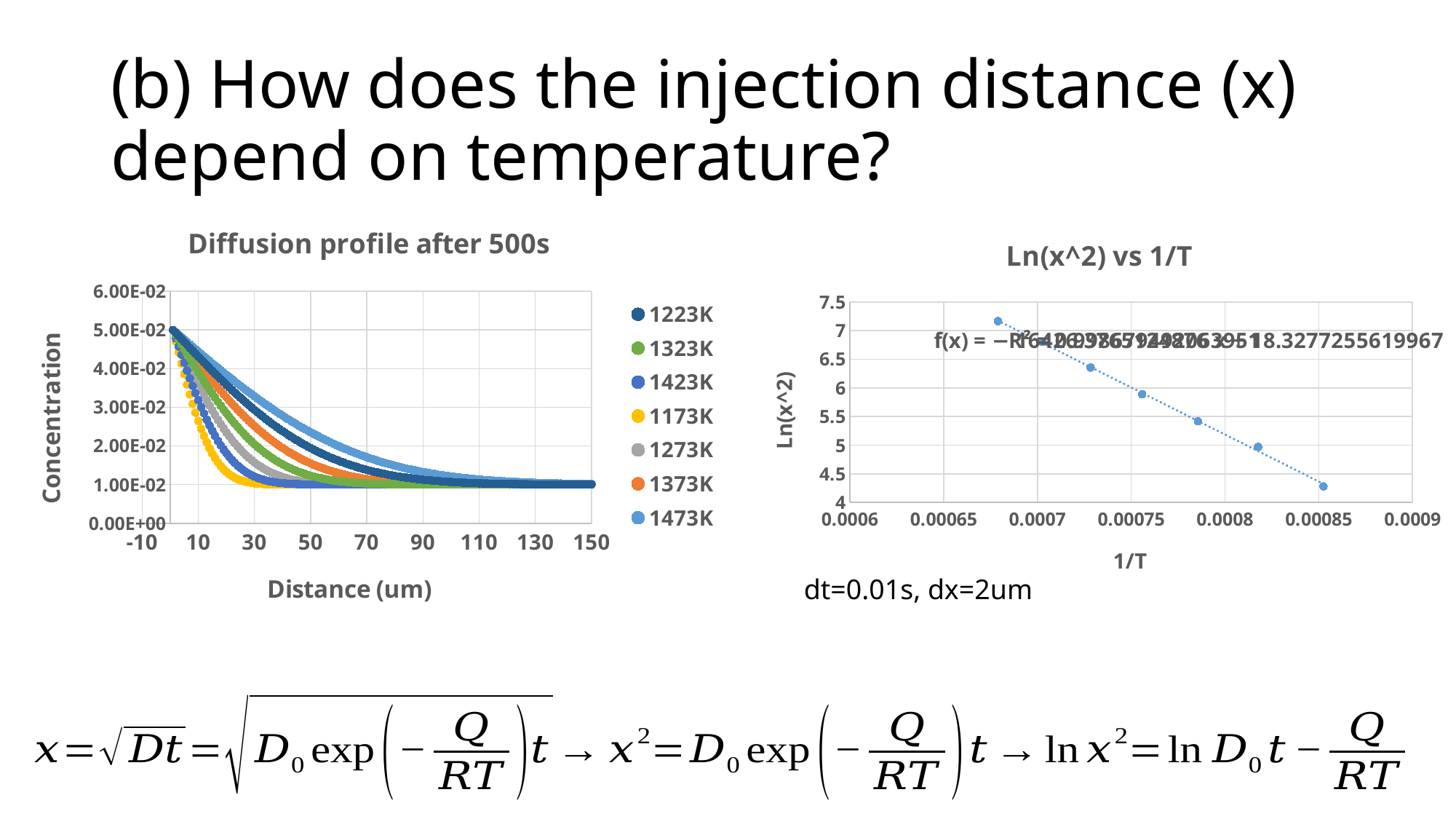
What is the x-axis label of the 'Diffusion profile after 500s' chart? Distance (um) What kind of chart is the 'Diffusion profile after 500s' chart? scatter chart In the 'Diffusion profile after 500s' chart, at a distance of 30 um, which series has the larger concentration, 1473K or 1173K? 1473K In the 'Ln(x^2) vs 1/T' chart, does Ln(x^2) rise or fall as 1/T increases? fall In the 'Diffusion profile after 500s' chart, is the concentration for 1473K at a distance of 50 um greater or less than 2.00E-02? greater In the 'Ln(x^2) vs 1/T' chart, is the value of Ln(x^2) at 1/T of about 0.00085 greater or less than 4.5? less In the 'Diffusion profile after 500s' chart, does concentration rise or fall as distance increases? fall In the 'Diffusion profile after 500s' chart, which series reaches the lowest concentration at the shortest distance? 1173K How many series does the legend of the 'Diffusion profile after 500s' chart list? 7 In the 'Diffusion profile after 500s' chart, is the concentration for 1173K at a distance of 30 um greater or less than 2.00E-02? less What is the y-axis label of the 'Ln(x^2) vs 1/T' chart? Ln(x^2)